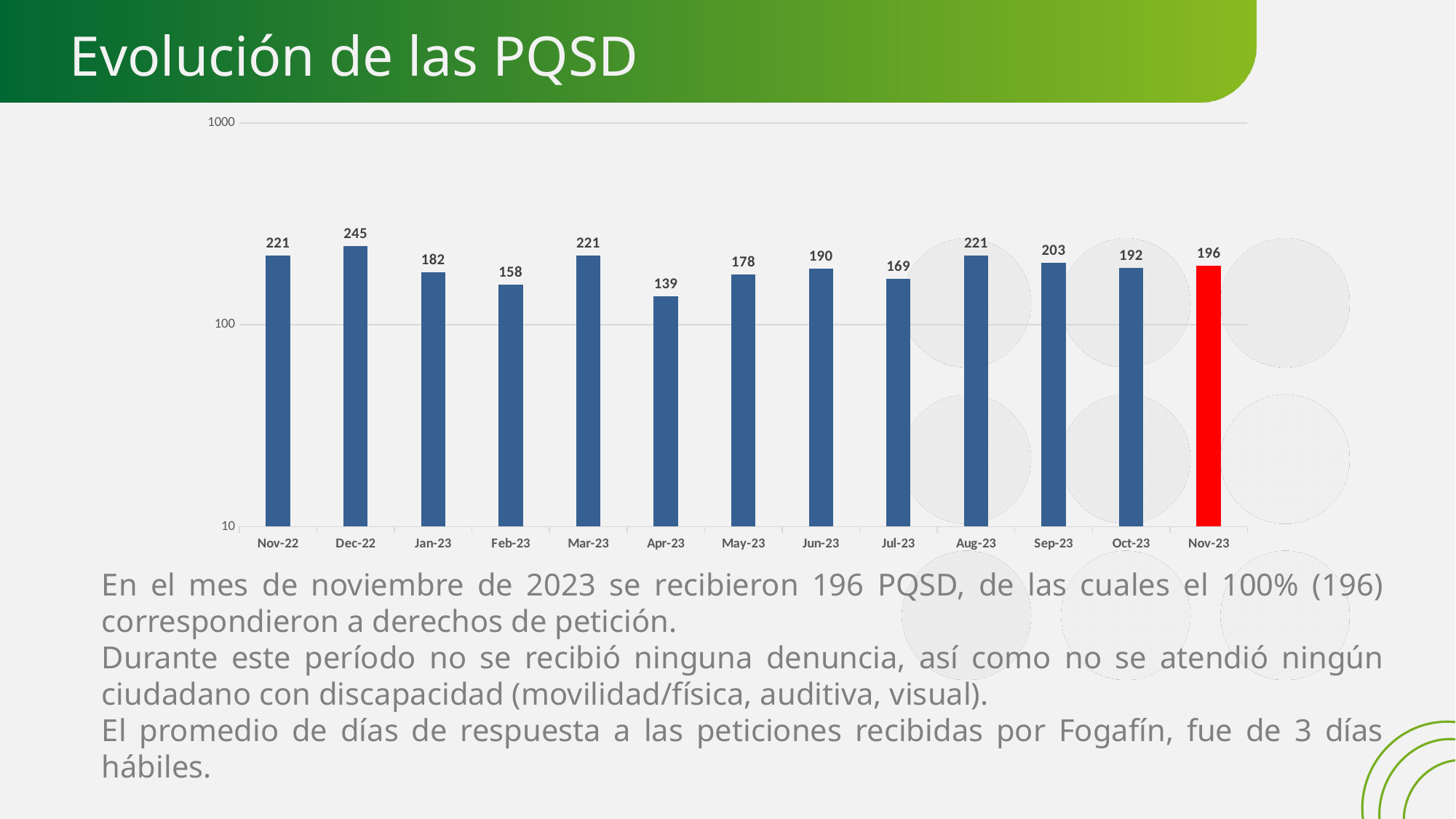
Which bar is coloured red? Nov-23 What is the difference between the values for Dec-22 and Apr-23? 106 Which month has the lowest value? Apr-23 What kind of chart is shown on the slide? bar chart What is the value for Dec-22? 245 Which is larger, the value for Sep-23 or the value for Oct-23? Sep-23 Do the values rise or fall from Jul-23 to Aug-23? rise What is the value for Apr-23? 139 Is the value for Feb-23 greater or less than 100? greater Which month has the highest value? Dec-22 What is the value for Nov-23? 196 How many months are shown on the x axis? 13